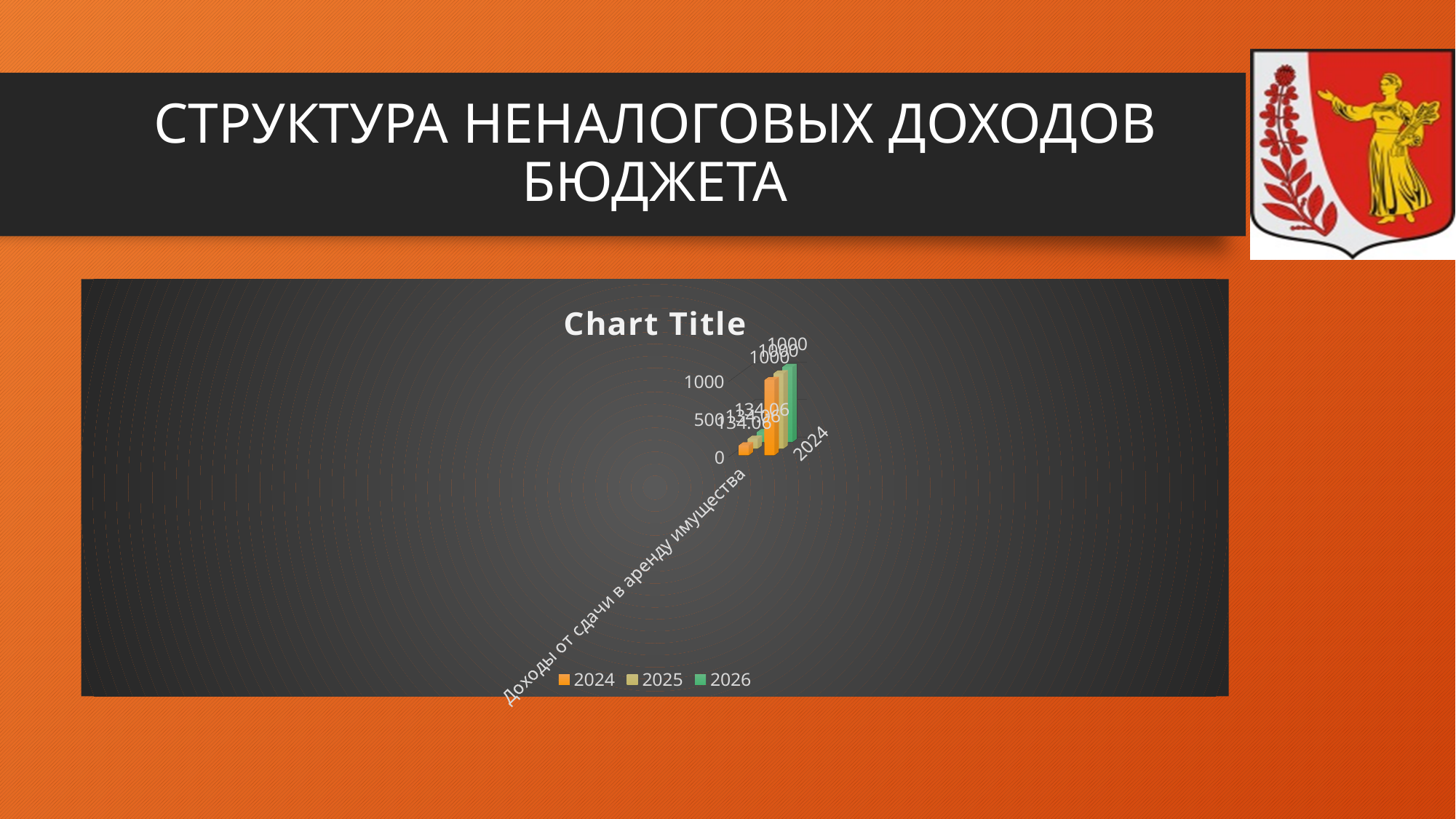
How many series does the chart legend list? 3 What are the series names listed in the chart legend? 2024, 2025, 2026 What kind of chart is shown on the slide? bar chart What is the title shown above the chart? Chart Title What is the highest tick value shown on the vertical axis of the chart? 1000 Is the value for the 2024 series in the category "Доходы от сдачи в аренду имущества" greater or less than 500? less What is the data label shown for the 2024 series in the category "Доходы от сдачи в аренду имущества"? 134.06